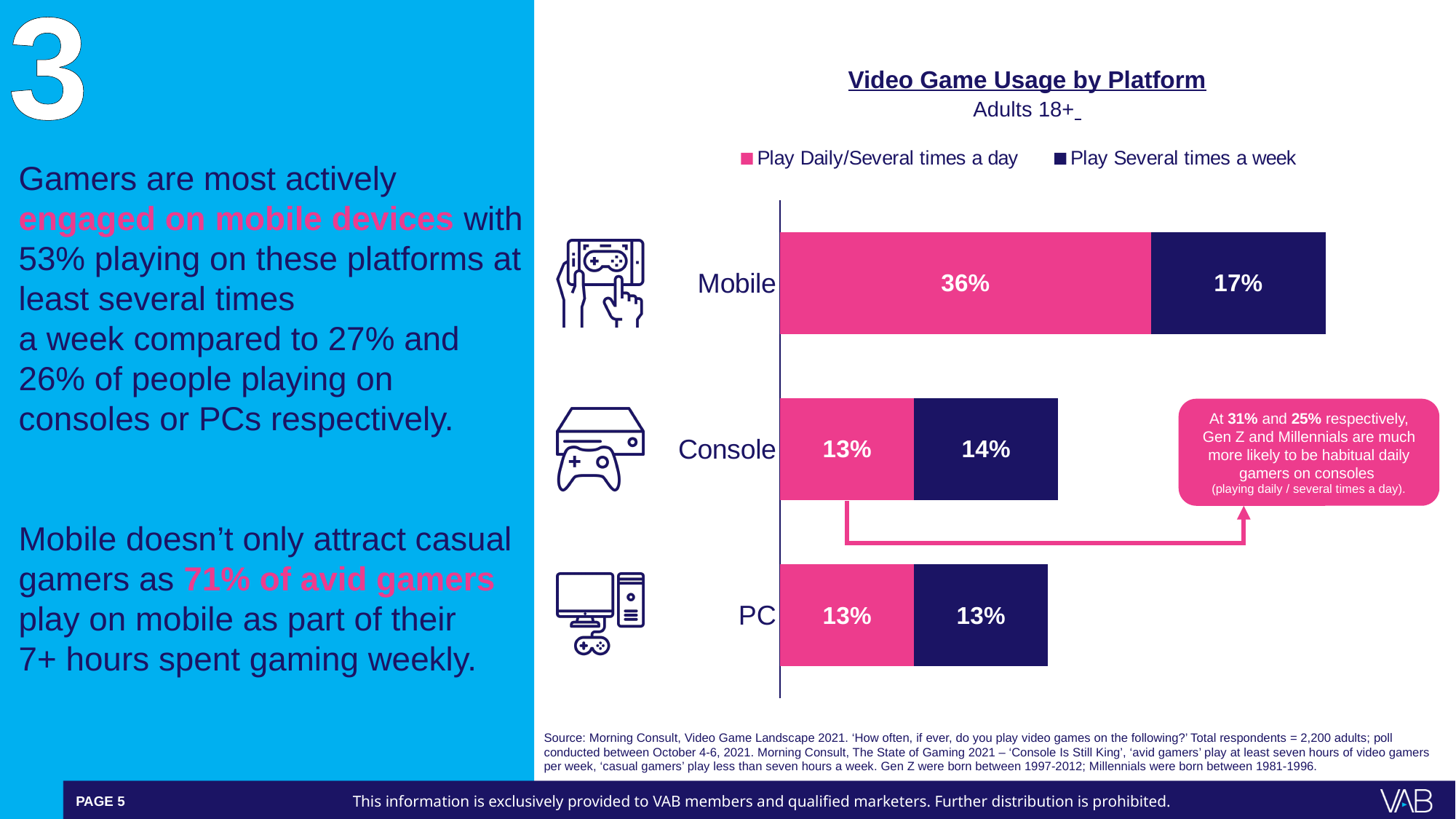
Which platform has the highest share of adults playing daily/several times a day? Mobile What percentage of adults play several times a week on Console? 14% Which platform has the lowest share of adults playing several times a week? PC What is the difference between the Mobile and Console values for playing daily/several times a day? 23% What is the total of the stacked bar for Mobile? 53% How many platforms are shown in the chart? 3 What percentage of adults play daily/several times a day on PC? 13% What is the total of the stacked bar for Console? 27% What percentage of adults play daily/several times a day on Mobile? 36% What type of chart is used to show video game usage by platform? Stacked bar chart How many series does the legend list? 2 Is the 'Play Several times a week' value larger for Mobile or for PC? Mobile